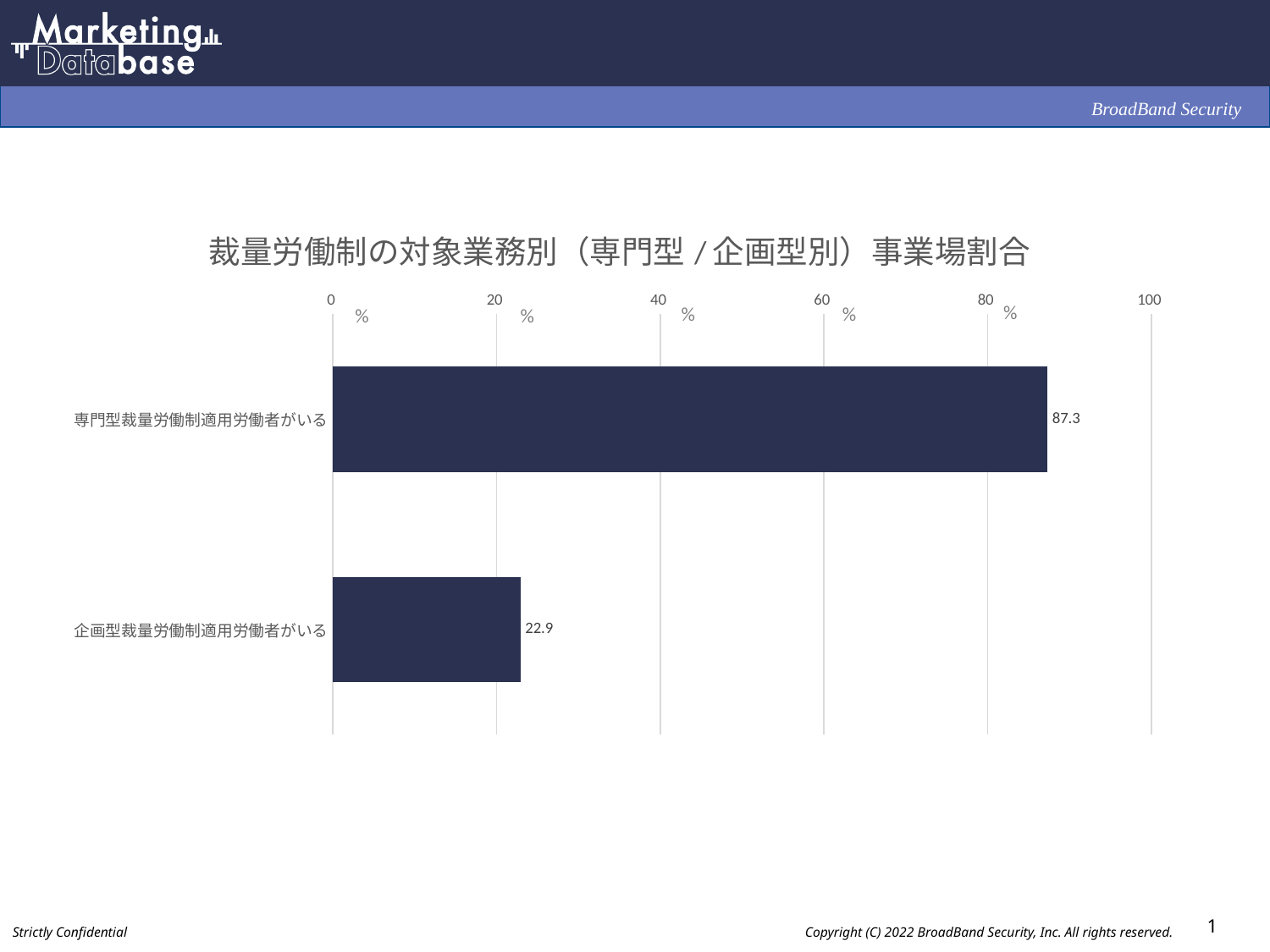
What is the maximum value shown on the horizontal axis? 100 Is the value for 専門型裁量労働制適用労働者がいる greater or less than 80%? greater What kind of chart is shown on the slide? bar chart What is the difference between the values for 専門型裁量労働制適用労働者がいる and 企画型裁量労働制適用労働者がいる? 64.4 What is the title of the chart? 裁量労働制の対象業務別（専門型／企画型別）事業場割合 Which is larger, the value for 専門型裁量労働制適用労働者がいる or the value for 企画型裁量労働制適用労働者がいる? 専門型裁量労働制適用労働者がいる Is the value for 企画型裁量労働制適用労働者がいる greater or less than 40%? less What is the value for 企画型裁量労働制適用労働者がいる? 22.9 Which category has the lowest value? 企画型裁量労働制適用労働者がいる Which category has the highest value? 専門型裁量労働制適用労働者がいる How many categories are shown in the chart? 2 What is the value for 専門型裁量労働制適用労働者がいる? 87.3